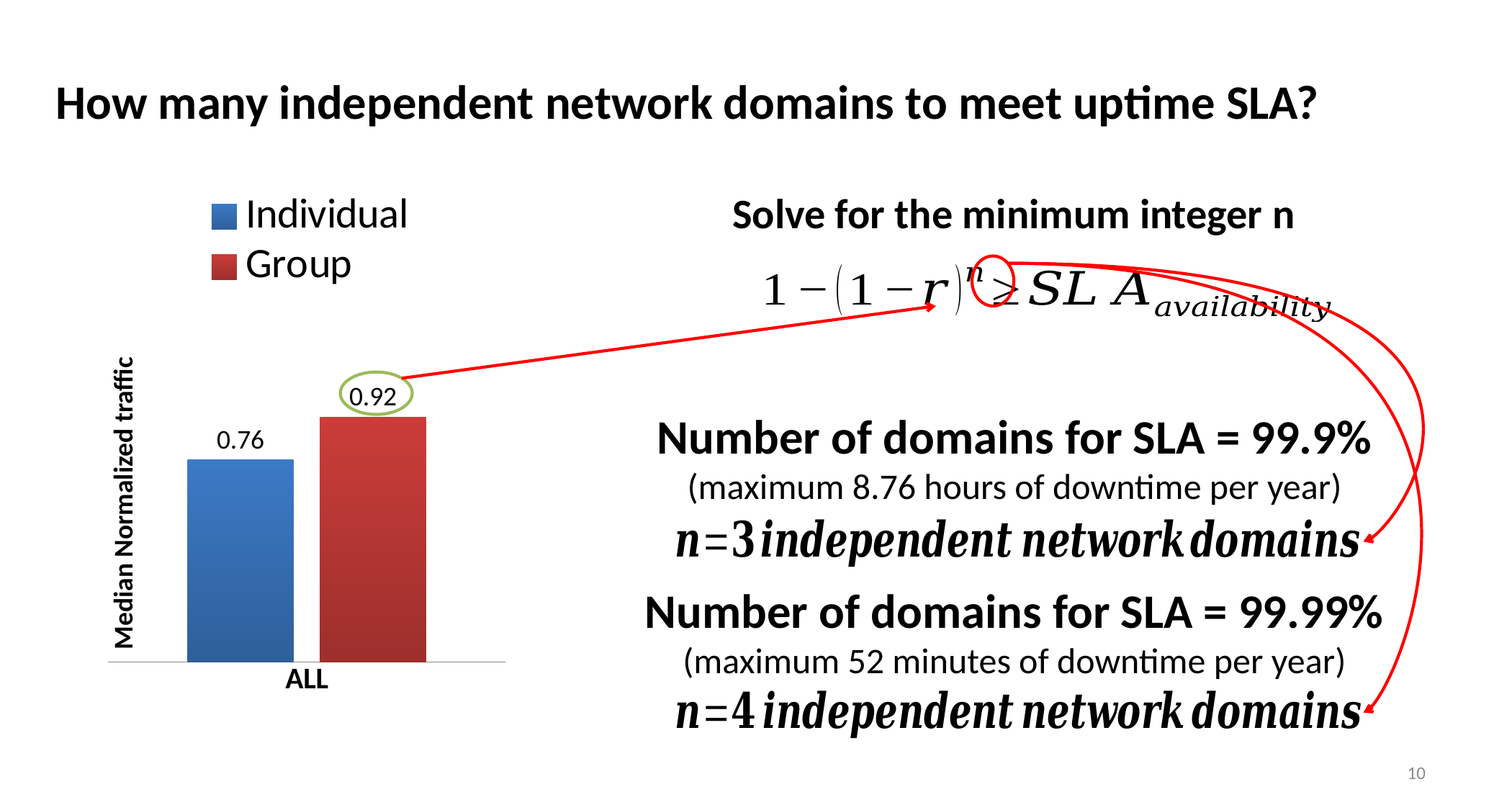
How many series does the legend list? 2 Which series has the lowest value in the chart? Individual What is the value for the Group series in the ALL category? 0.92 How many categories are shown on the x axis? 1 What colour is the Group series bar? red Which series has the higher value for the ALL category, Individual or Group? Group What is the category label on the x axis? ALL Which series has the highest value in the chart? Group What is the value for the Individual series in the ALL category? 0.76 What is the label of the y axis? Median Normalized traffic What kind of chart is shown on the slide? bar chart What is the difference between the Group value and the Individual value for ALL? 0.16